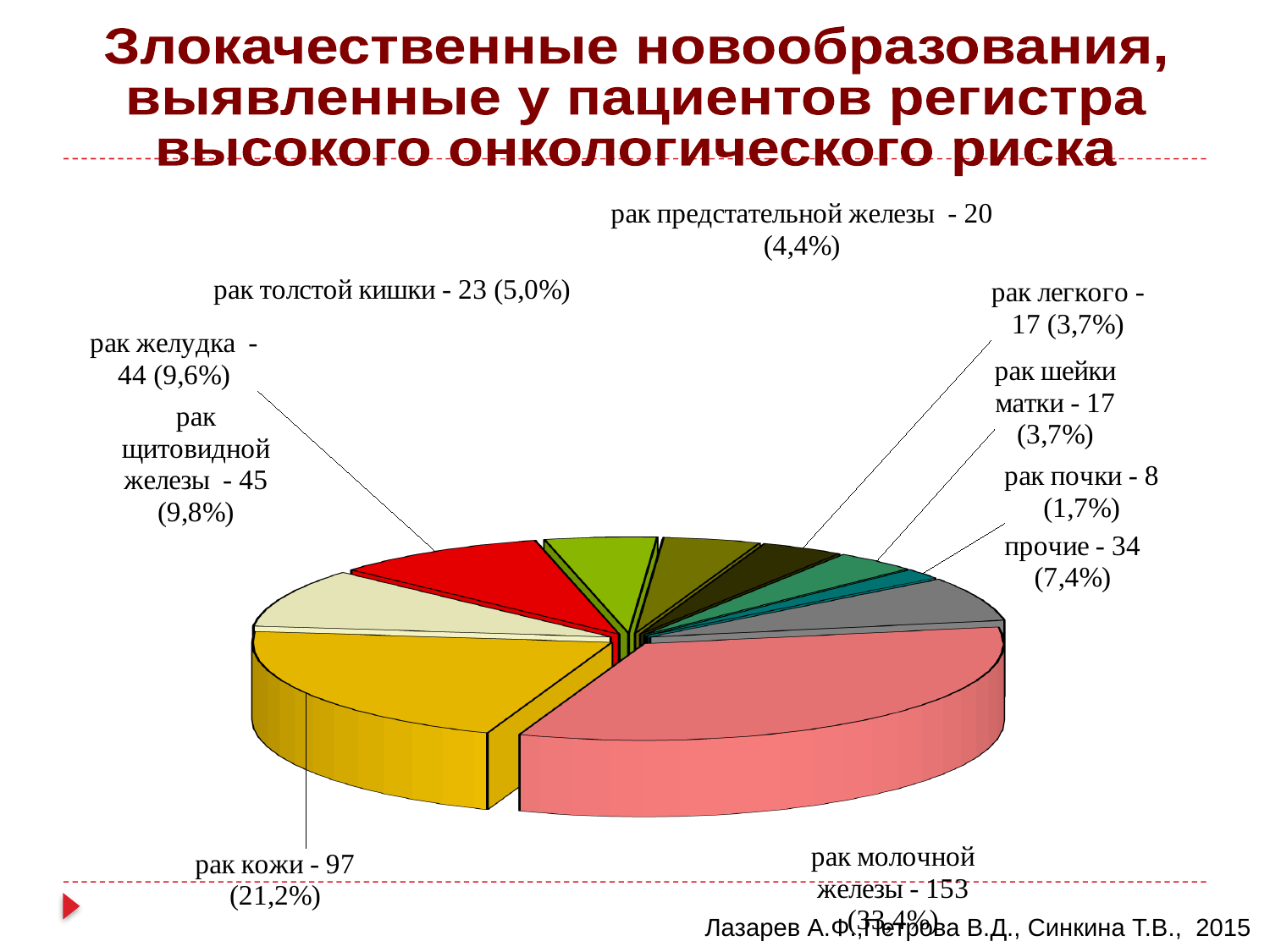
How many cases are shown for рак молочной железы? 153 Which category has the largest slice of the pie chart? рак молочной железы Which has more cases, рак толстой кишки or рак предстательной железы? рак толстой кишки How many categories (slices) does the pie chart have? 10 What kind of chart is shown on the slide? pie chart How many cases are shown for рак кожи? 97 What is the difference in cases between рак щитовидной железы and рак желудка? 1 What share of the pie does прочие represent? 7,4% What share of the pie does рак легкого represent? 3,7% Which category has the smallest slice of the pie chart? рак почки What share of the pie does рак желудка represent? 9,6% What is the difference in cases between рак молочной железы and рак кожи? 56